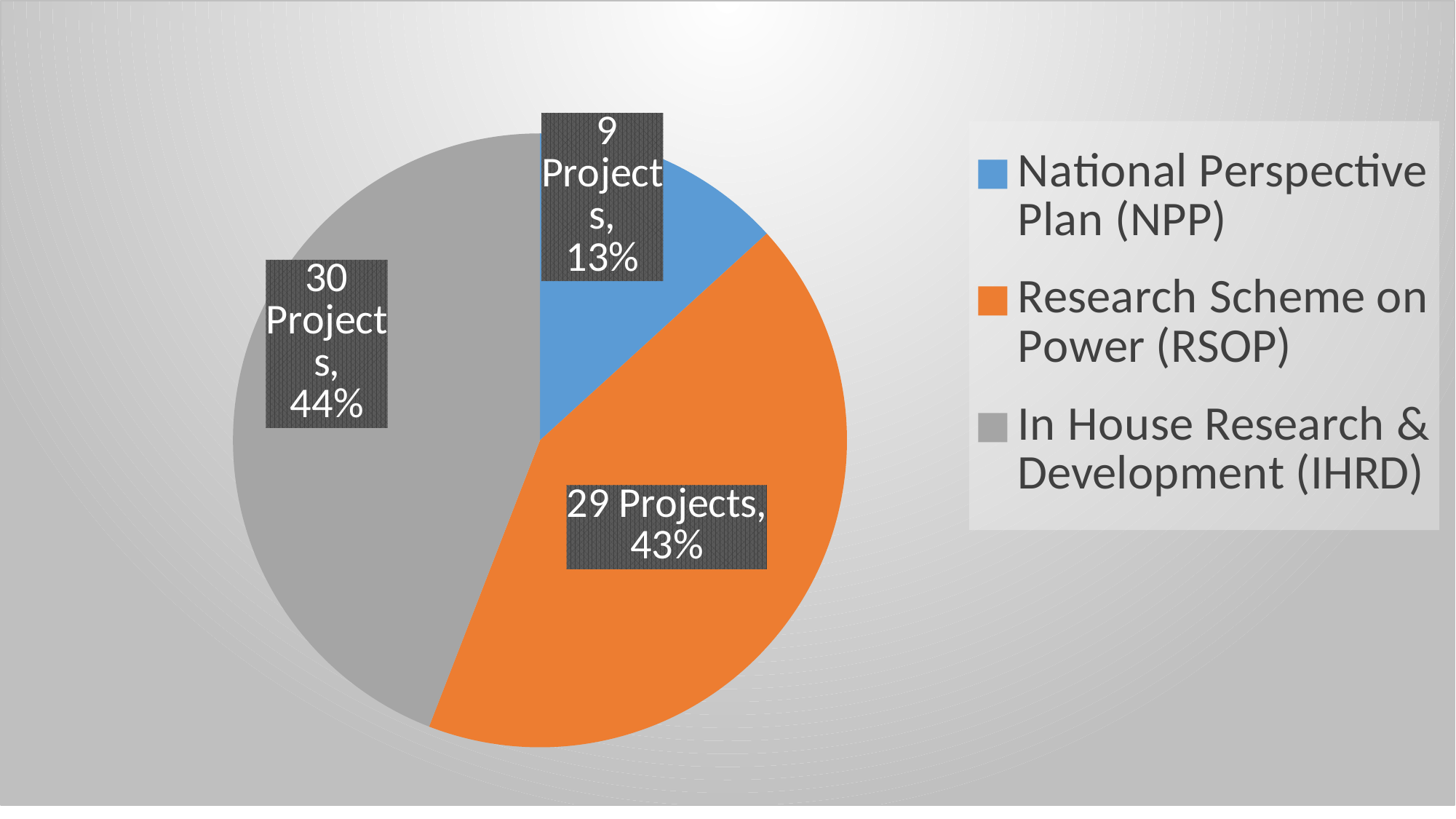
Which category has the smallest number of projects? National Perspective Plan (NPP) How many projects are shown for In House Research & Development (IHRD)? 30 Projects Which has more projects, Research Scheme on Power (RSOP) or National Perspective Plan (NPP)? Research Scheme on Power (RSOP) What percentage share does National Perspective Plan (NPP) have? 13% What is the total number of projects across all three categories? 68 What type of chart is shown on the slide? Pie chart What percentage of the pie does Research Scheme on Power (RSOP) account for? 43% Which category has the largest number of projects? In House Research & Development (IHRD) How many projects are shown for National Perspective Plan (NPP)? 9 Projects Which colour represents Research Scheme on Power (RSOP) in the legend? Orange What is the difference in the number of projects between IHRD and NPP? 21 How many categories are shown in the pie chart? 3